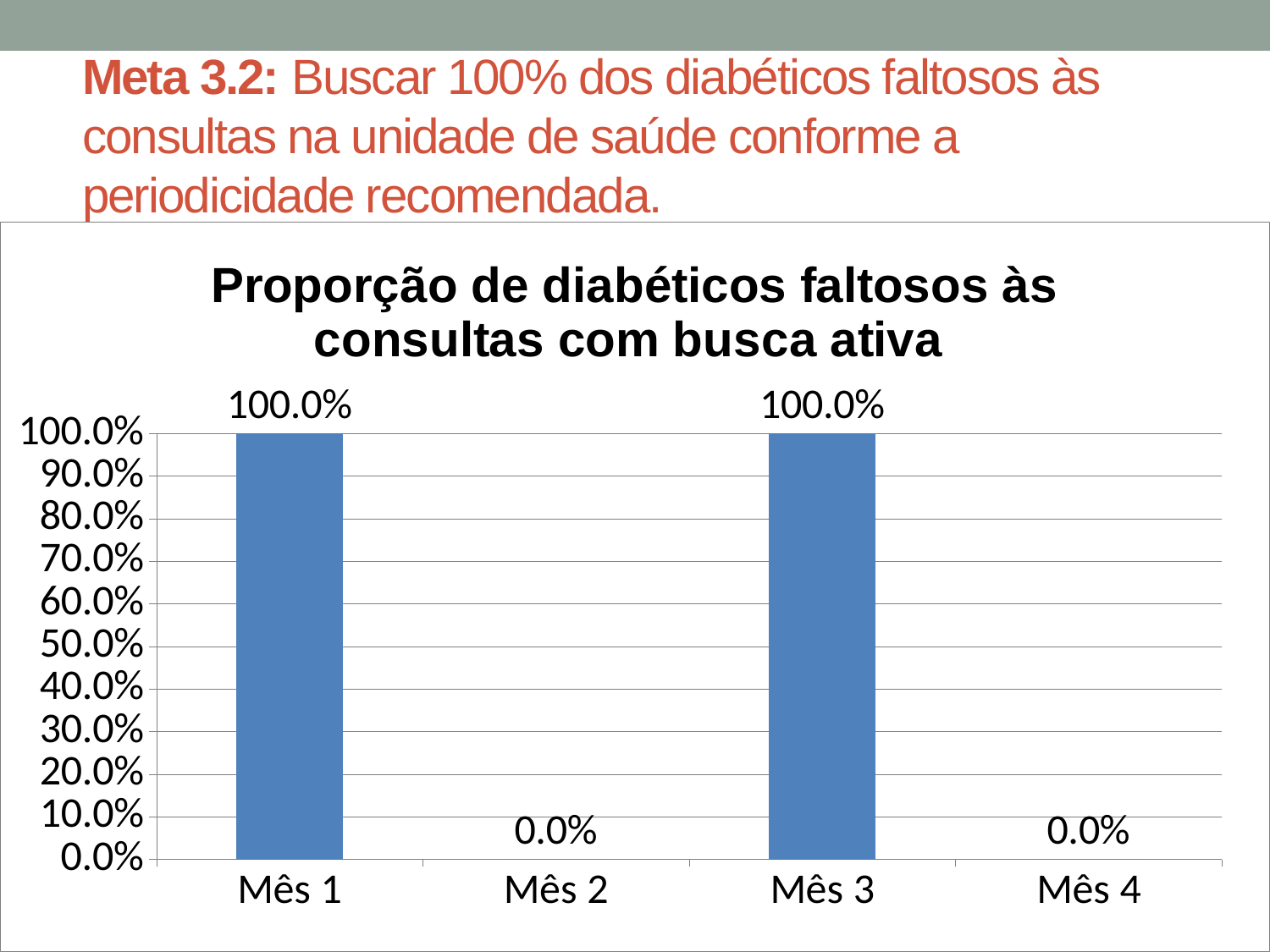
What kind of chart is shown on the slide? bar chart What is the value for Mês 1? 100.0% Is the value for Mês 1 greater or less than 50.0%? greater What is the value for Mês 4? 0.0% What is the value for Mês 2? 0.0% What colour are the bars in the chart? blue What is the difference between the values for Mês 1 and Mês 2? 100.0% What is the title of the chart? Proporção de diabéticos faltosos às consultas com busca ativa What is the value for Mês 3? 100.0% Which is larger, the value for Mês 3 or the value for Mês 4? Mês 3 How many categories are shown on the x axis? 4 Do the values rise or fall from Mês 1 to Mês 2? fall